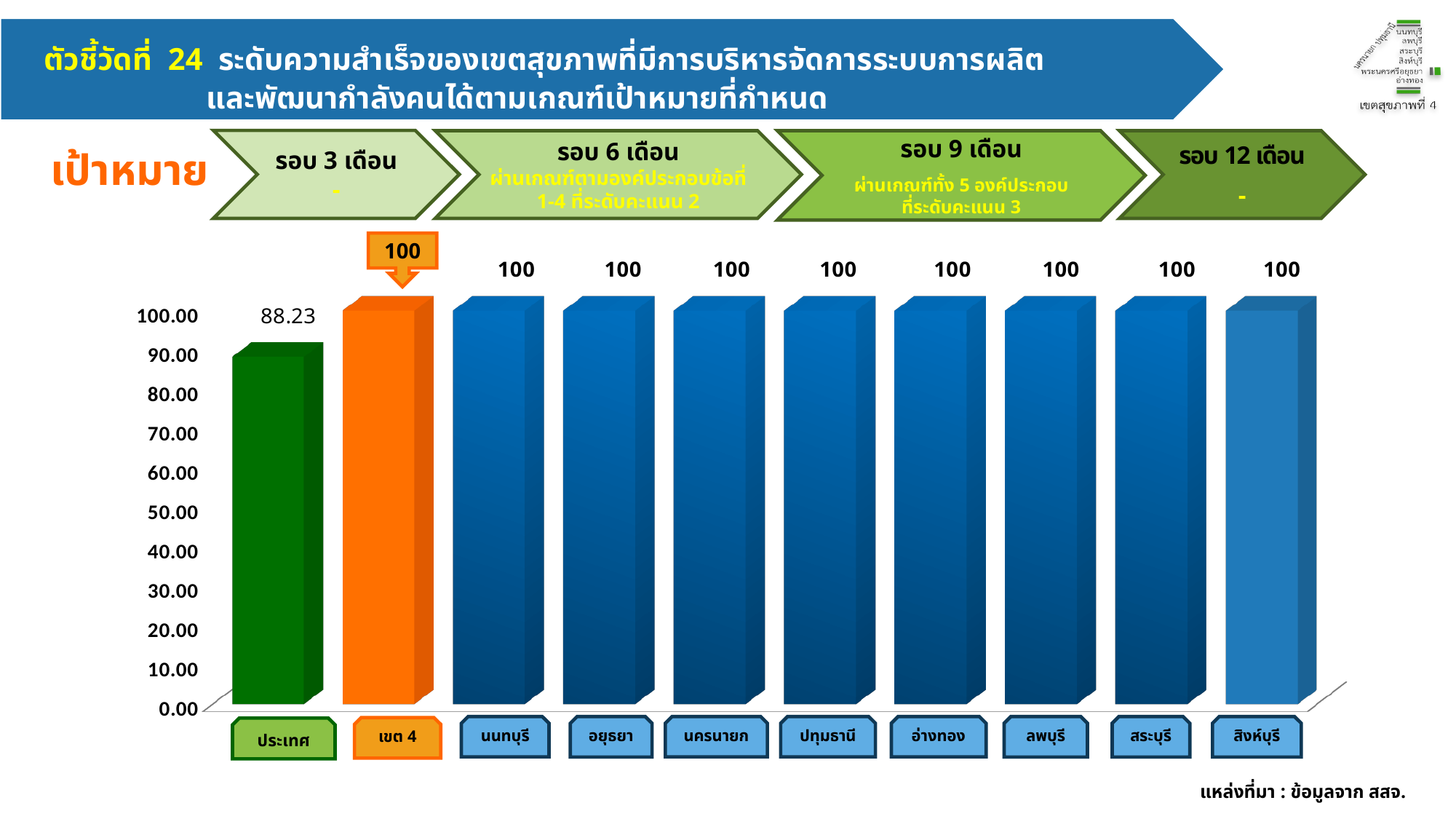
How many categories have a value of 100? 9 What is the value for สิงห์บุรี? 100 Is the value for ประเทศ greater or less than 90.00? less Which is larger, the value for ประเทศ or the value for ปทุมธานี? ปทุมธานี What is the value for นนทบุรี? 100 What colour is the bar for เขต 4? orange Which category has the lowest value? ประเทศ What is the value for ประเทศ? 88.23 What is the value for เขต 4? 100 How many categories are shown on the x axis of the chart? 10 What is the difference between the value for เขต 4 and the value for ประเทศ? 11.77 What kind of chart is shown on the slide? bar chart